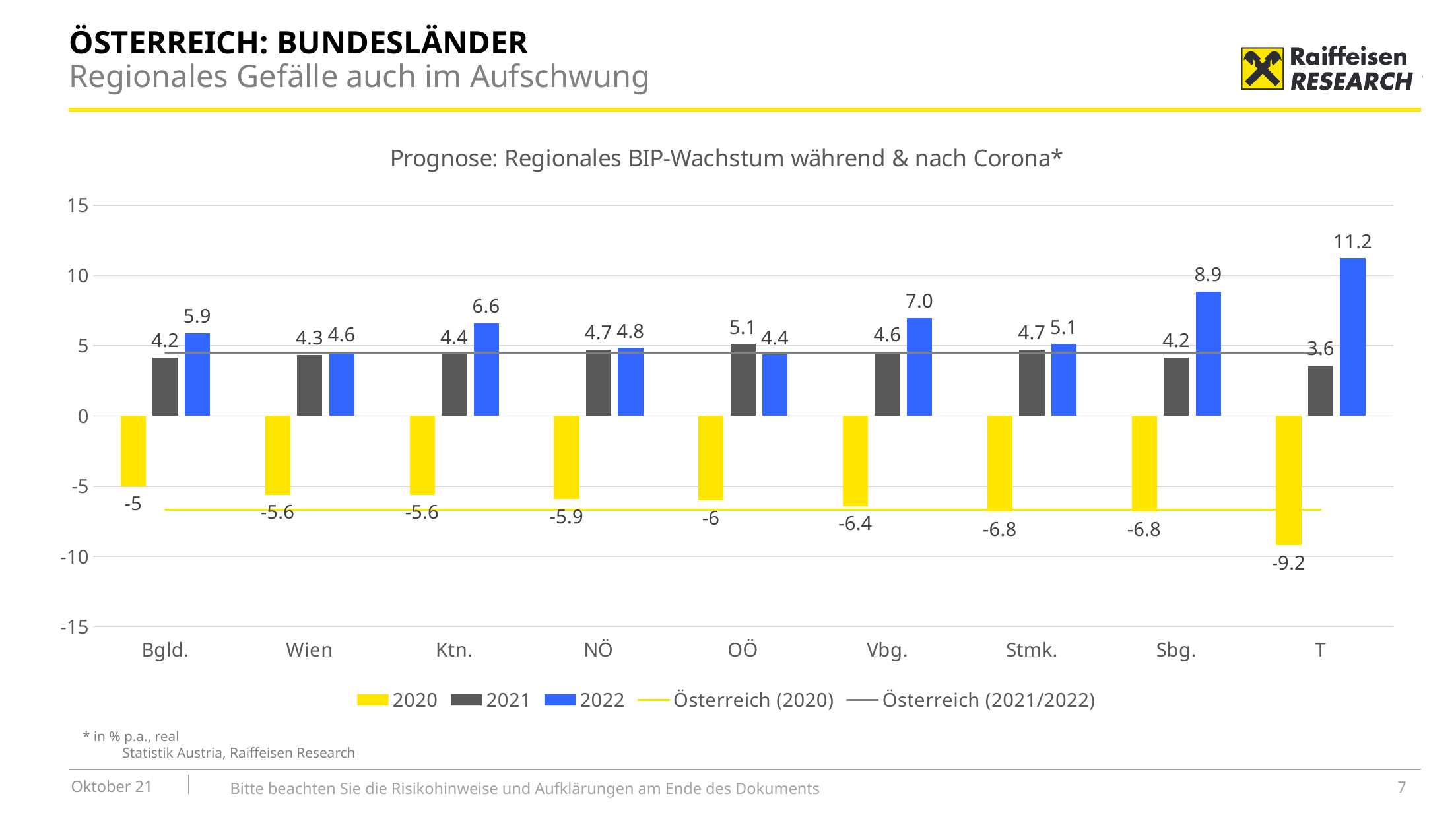
Which category has the highest 2021 value? OÖ How many entries does the legend list? 5 What is the 2022 value for T? 11.2 What is the title of the chart? Prognose: Regionales BIP-Wachstum während & nach Corona* Which category has the highest 2022 value? T What is the 2021 value for Wien? 4.3 How many categories are shown on the x axis? 9 Which category has the lowest 2020 value? T What is the difference between the 2022 and 2021 values for T? 7.6 For OÖ, which is larger: the 2021 value or the 2022 value? 2021 What is the 2020 value for Sbg.? -6.8 What kind of chart is shown on the slide? Combination bar and line chart